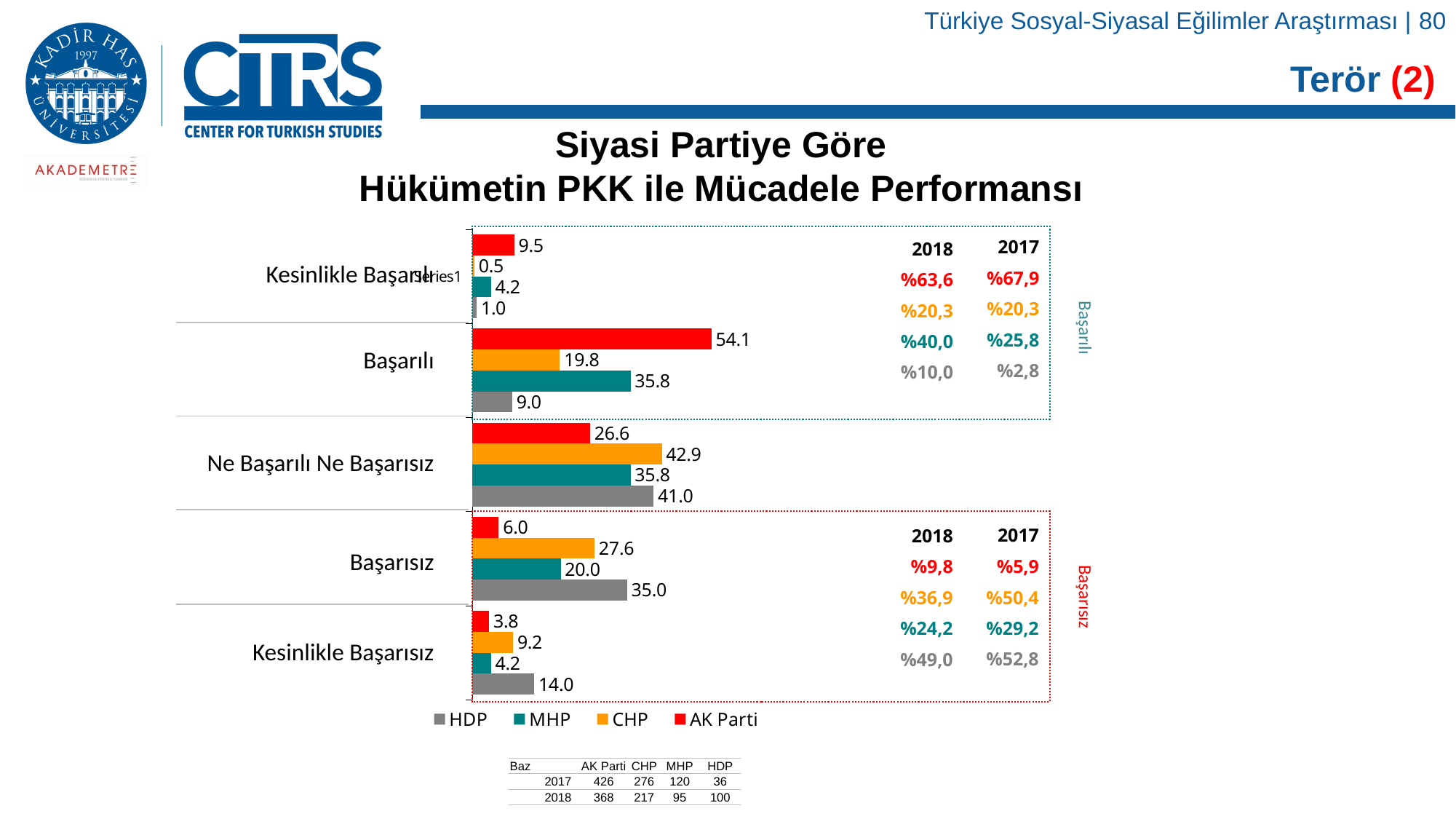
Which colour represents HDP in the chart? Grey What is the value for CHP in the Başarısız category? 27.6 What is the value for HDP in the Ne Başarılı Ne Başarısız category? 41.0 What kind of chart is shown on the slide? Bar chart What is the difference between the AK Parti and HDP values in the Başarılı category? 45.1 How many series does the legend list? 4 Which party has the highest value in the Başarılı category? AK Parti In the Ne Başarılı Ne Başarısız category, which is larger: the CHP value or the AK Parti value? CHP How many categories are shown on the chart? 5 Which party has the lowest value in the Kesinlikle Başarılı category? CHP What is the value for AK Parti in the Başarılı category? 54.1 What is the value for MHP in the Kesinlikle Başarısız category? 4.2